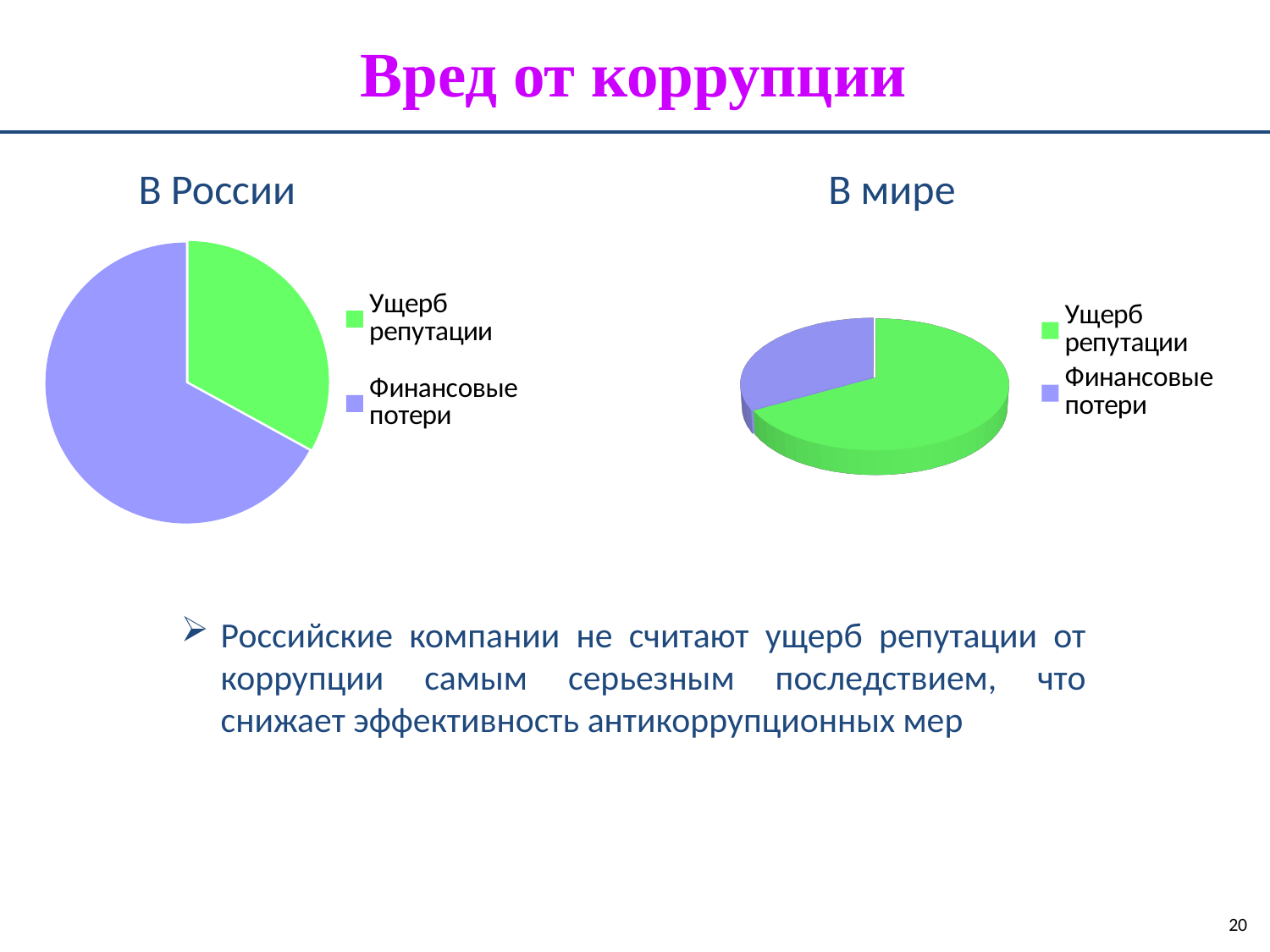
In the "В России" chart, which category has the smallest slice? Ущерб репутации In the "В России" chart, which is larger: Ущерб репутации or Финансовые потери? Финансовые потери In the "В мире" chart, which category has the smallest slice? Финансовые потери How many slices does the "В России" pie chart have? 2 In the "В мире" chart, which category has the largest slice? Ущерб репутации How many entries does the legend of the "В России" chart list? 2 In the "В России" chart, which category has the largest slice? Финансовые потери In the "В мире" chart, which is larger: Ущерб репутации or Финансовые потери? Ущерб репутации What colour represents Ущерб репутации in the "В мире" chart? green What kind of chart is the "В России" chart? pie chart What kind of chart is the "В мире" chart? pie chart How many slices does the "В мире" pie chart have? 2